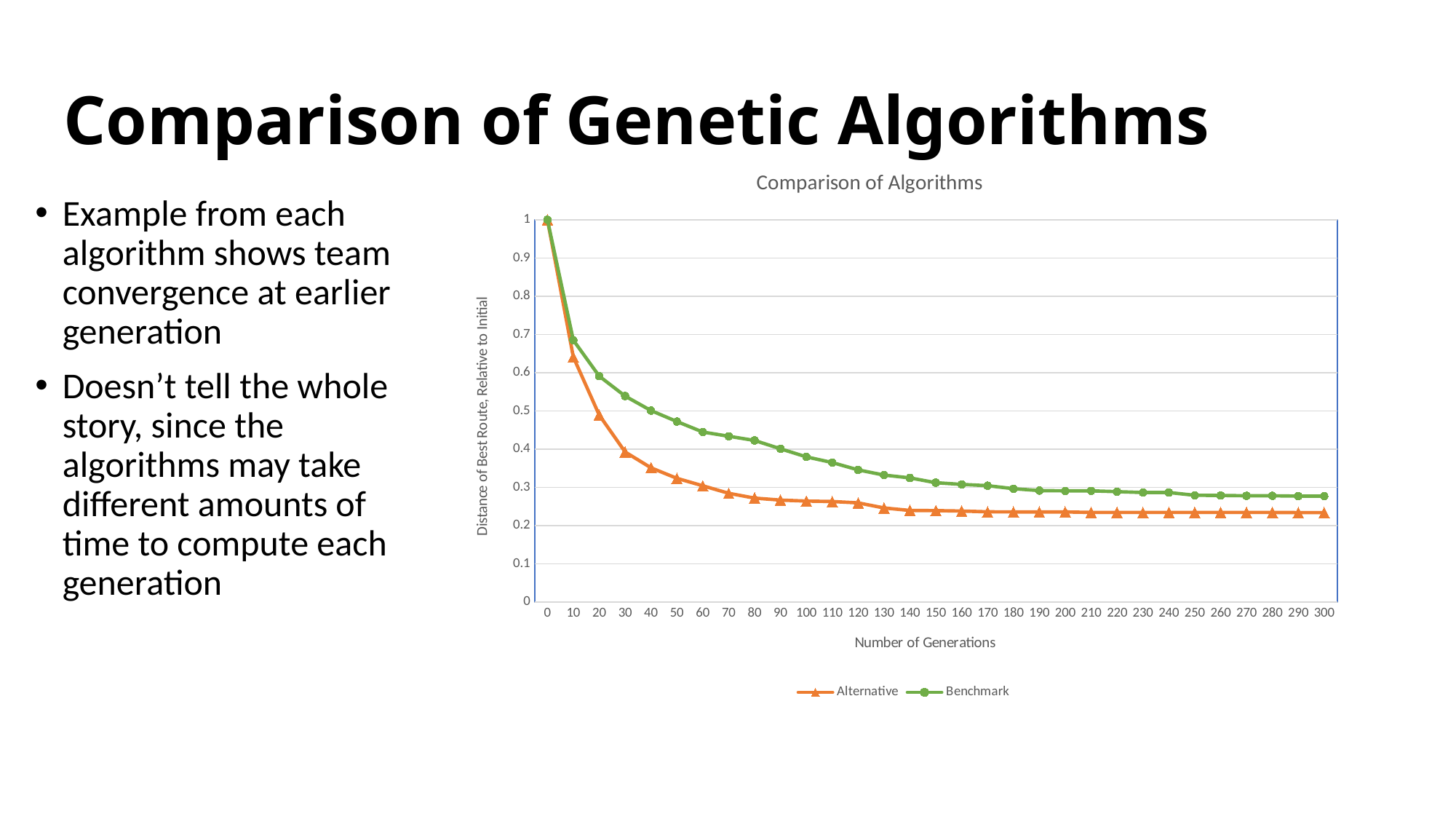
Do the values of the Benchmark series rise or fall as the number of generations increases? fall What is the label of the vertical axis of the chart? Distance of Best Route, Relative to Initial How many points along the Number of Generations axis are plotted for each series? 31 What is the value of the Alternative series at 0 generations? 1 At which number of generations is the Benchmark value highest? 0 Is the value for the Alternative series at 50 generations greater or less than 0.4? less At 100 generations, which series has the larger value, Alternative or Benchmark? Benchmark Is the value for the Alternative series at 300 generations greater or less than 0.3? less What is the title of the chart? Comparison of Algorithms What kind of chart is shown on the slide? line chart How many series does the legend of the chart list? 2 Is the value for the Benchmark series at 50 generations greater or less than 0.4? greater